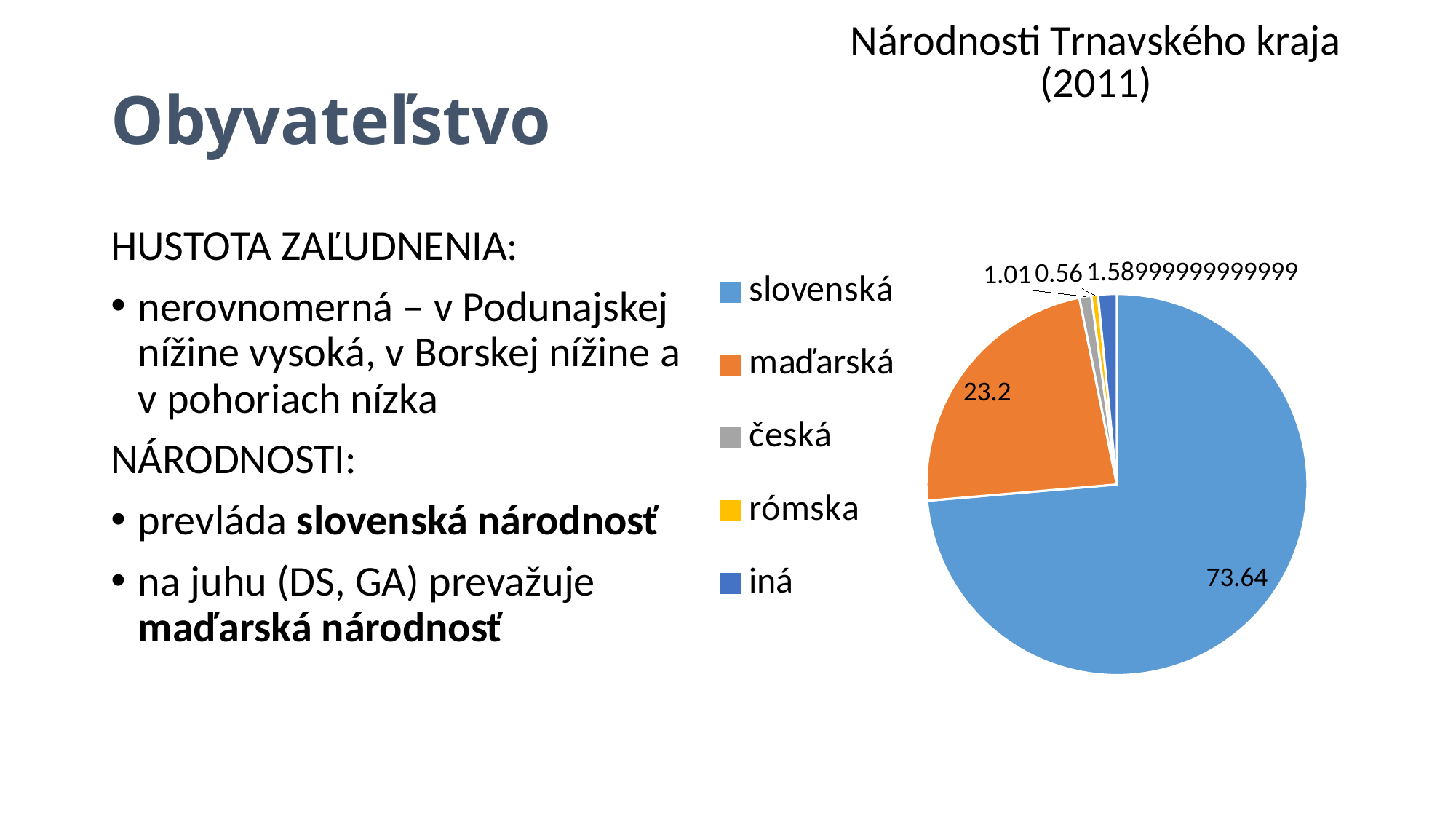
What is the value shown for slovenská? 73.64 What is the title of the chart? Národnosti Trnavského kraja (2011) What type of chart is shown on the slide? pie chart What is the difference between the values for slovenská and maďarská? 50.44 Which is larger, the value for česká or the value for rómska? česká How many categories does the pie chart show? 5 What is the value shown for maďarská? 23.2 Which colour represents maďarská in the chart? orange Which nationality has the largest slice of the pie? slovenská Which nationality has the smallest slice of the pie? rómska What is the value shown for rómska? 0.56 What is the value shown for česká? 1.01